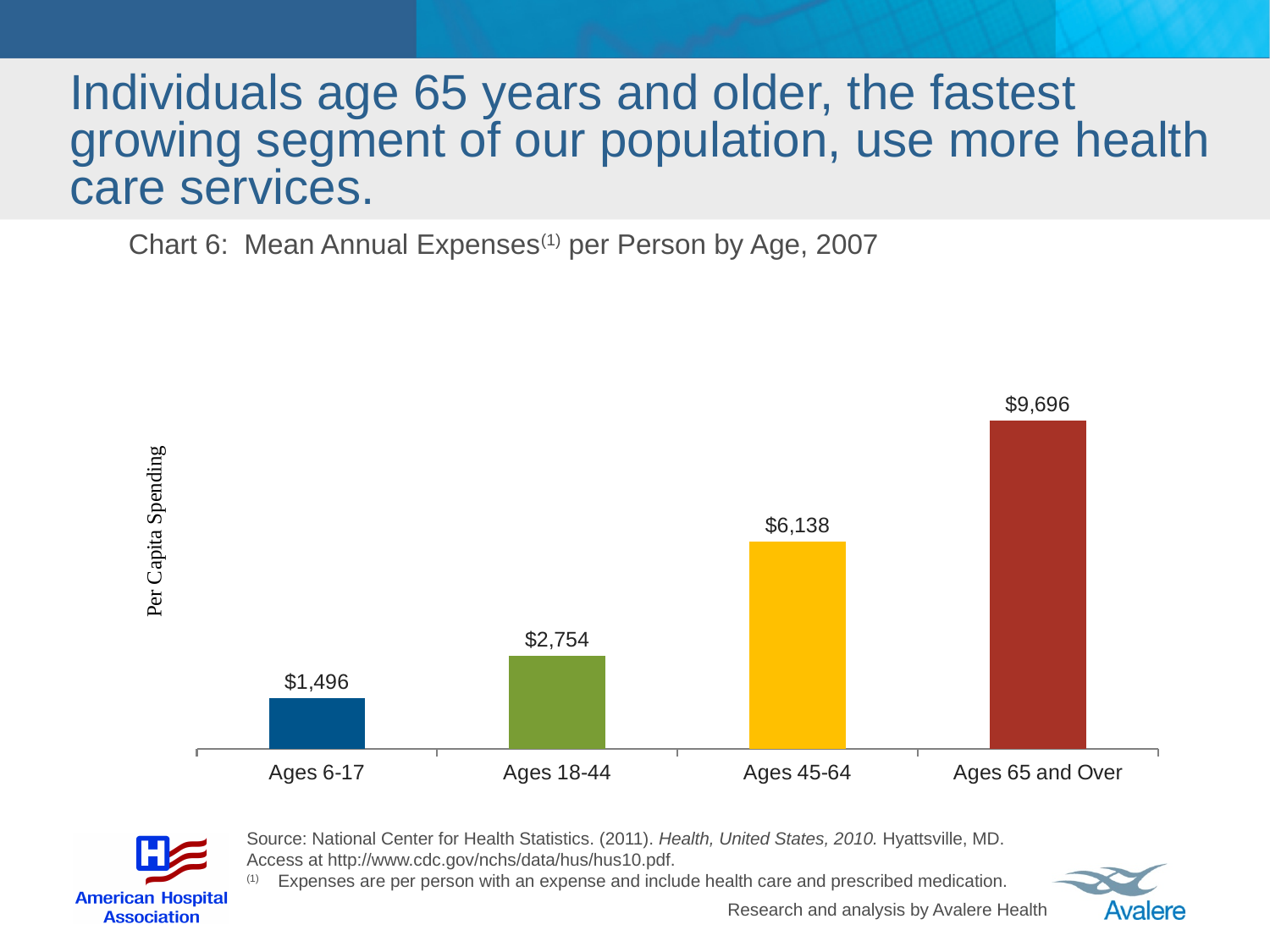
What is the mean annual expense per person for Ages 45-64? $6,138 Which has a higher mean annual expense per person, Ages 18-44 or Ages 45-64? Ages 45-64 Do mean annual expenses rise or fall as age group increases along the x axis? Rise What is the difference in mean annual expenses between Ages 65 and Over and Ages 45-64? $3,558 Which age group has the lowest mean annual expense per person? Ages 6-17 What is the mean annual expense per person for Ages 18-44? $2,754 What is the mean annual expense per person for Ages 6-17? $1,496 Which age group has the highest mean annual expense per person? Ages 65 and Over How many age groups are shown in the chart? 4 What is the mean annual expense per person for Ages 65 and Over? $9,696 What is the difference in mean annual expenses between Ages 18-44 and Ages 6-17? $1,258 What type of chart is used to show mean annual expenses by age? Bar chart